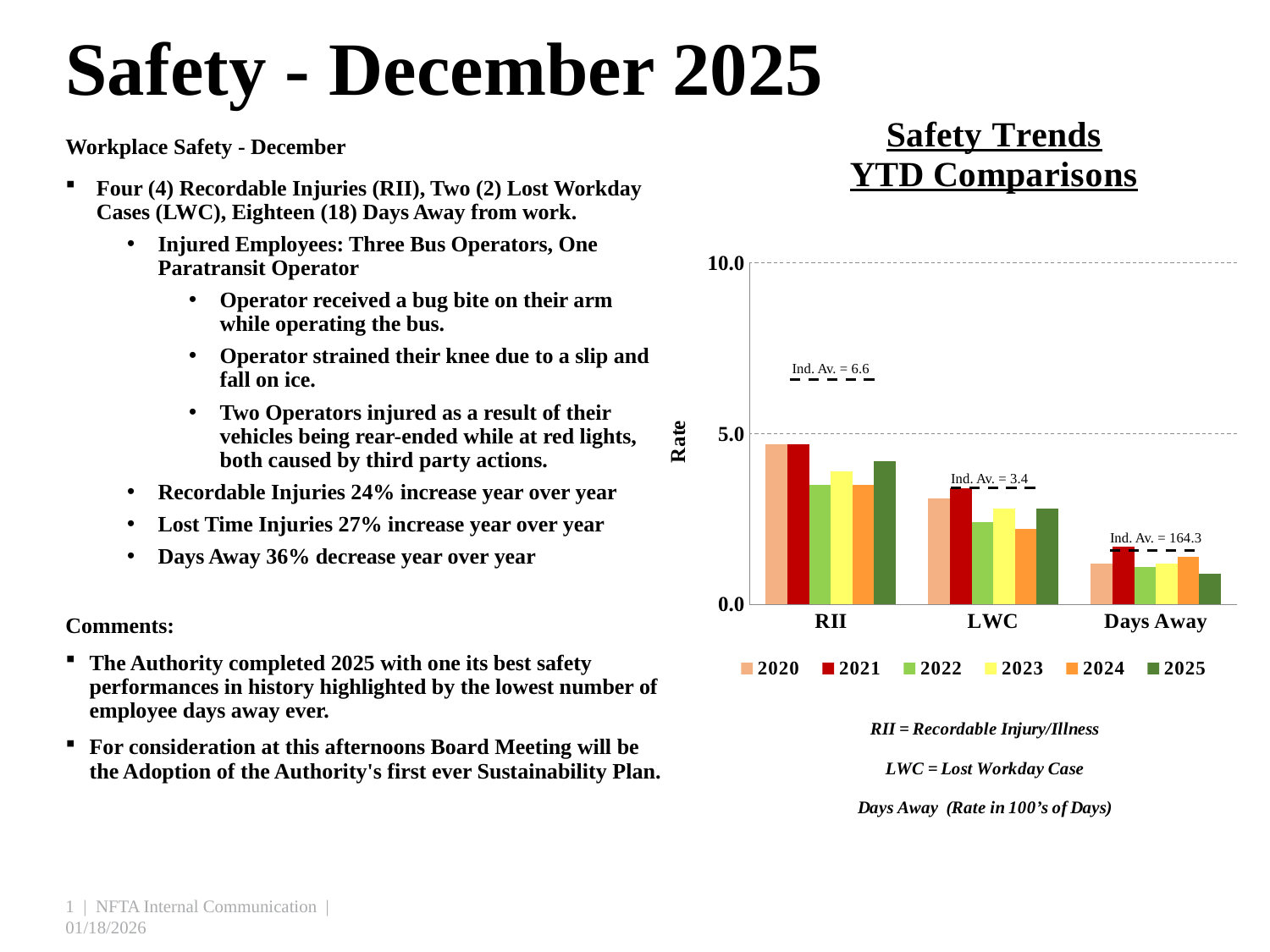
What industry average value is annotated above the Days Away bars in the Safety Trends chart? Ind. Av. = 164.3 In the Safety Trends chart, is the 2020 value for RII greater or less than 5.0? less What industry average value is annotated above the RII bars in the Safety Trends chart? Ind. Av. = 6.6 How many series does the legend of the Safety Trends chart list? 6 What kind of chart is shown under the title "Safety Trends YTD Comparisons"? bar chart In the Safety Trends chart, is the 2025 value for Days Away greater or less than 5.0? less What is the label on the vertical axis of the Safety Trends chart? Rate In the Safety Trends chart, is the 2020 bar larger for RII or for LWC? RII In the Safety Trends chart, which category has the tallest bars overall: RII, LWC or Days Away? RII What industry average value is annotated above the LWC bars in the Safety Trends chart? Ind. Av. = 3.4 In the Safety Trends chart, which year has the highest bar in the Days Away category? 2021 How many categories are shown on the x axis of the Safety Trends chart? 3